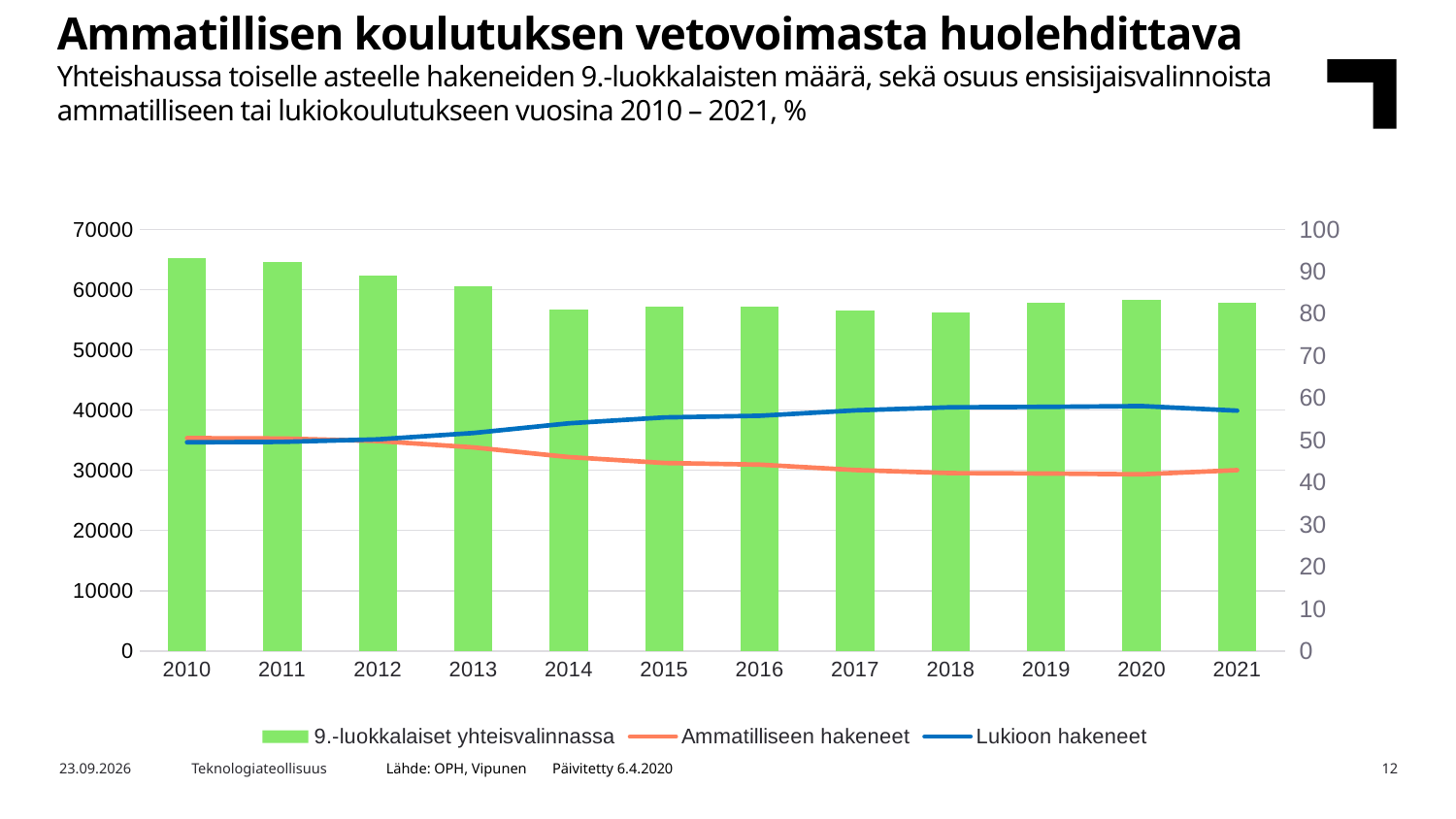
How many years are shown on the x axis? 12 In 2021, which is higher: Lukioon hakeneet or Ammatilliseen hakeneet? Lukioon hakeneet Which year has the highest bar for 9.-luokkalaiset yhteisvalinnassa? 2010 Is the bar for 9.-luokkalaiset yhteisvalinnassa in 2010 greater or less than 60000? greater What kind of chart is shown on the slide? A combined bar and line chart Is the bar for 9.-luokkalaiset yhteisvalinnassa in 2015 greater or less than 60000? less What colour are the bars for 9.-luokkalaiset yhteisvalinnassa? Green Does the Lukioon hakeneet line rise or fall from 2010 to 2021? rise How many series does the legend list? 3 Is the value for Lukioon hakeneet in 2020 greater or less than 50 on the right axis? greater Does the Ammatilliseen hakeneet line rise or fall from 2010 to 2021? fall